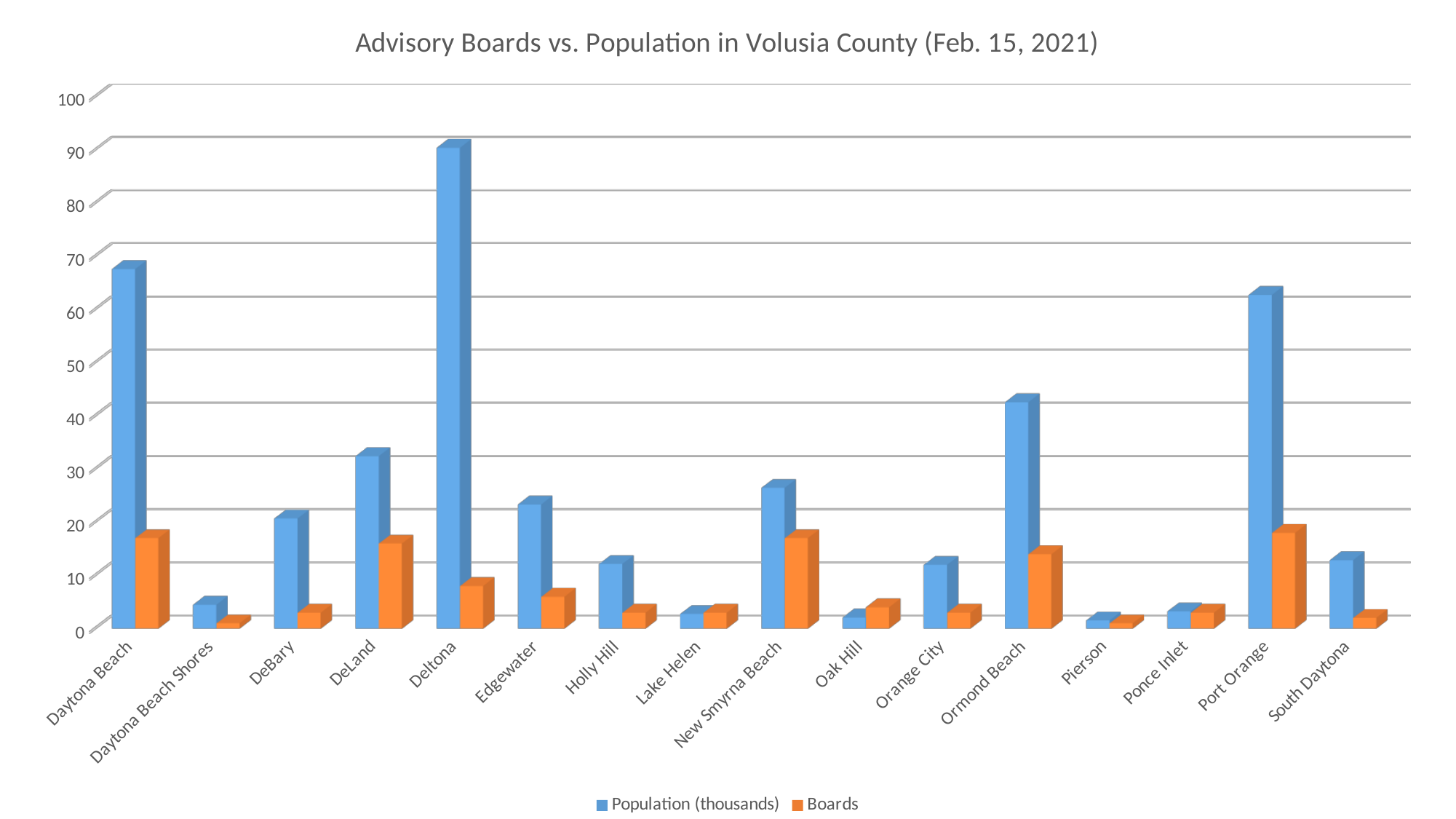
What kind of chart is shown on the slide? Bar chart What is the title of the chart? Advisory Boards vs. Population in Volusia County (Feb. 15, 2021) Is the Boards value for DeLand greater or less than 10? greater How many cities are shown on the x axis? 16 Which has the larger Population (thousands) value, Ormond Beach or DeLand? Ormond Beach Is the Population (thousands) value for Daytona Beach greater or less than 60? greater Which has the larger Boards value, DeLand or Deltona? DeLand Is the Population (thousands) value for Deltona greater or less than 80? greater Which city has the highest Population (thousands) value? Deltona How many series does the legend list? 2